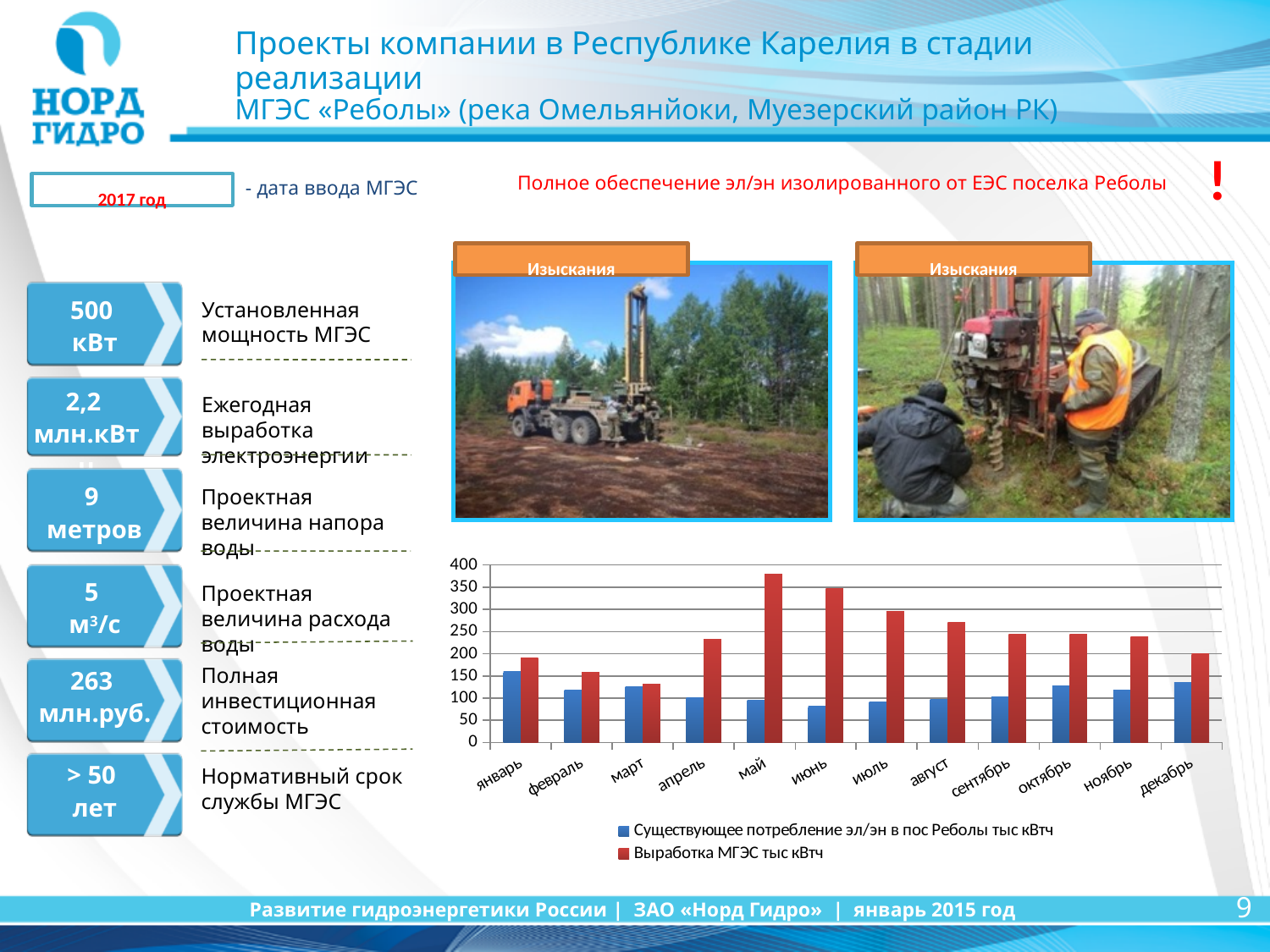
How many series does the chart legend list? 2 In which month is the value for 'Выработка МГЭС тыс кВтч' the highest? май How many months are shown along the x axis of the chart? 12 In which month is the value for 'Существующее потребление эл/эн в пос Реболы тыс кВтч' the highest? январь Is the value for 'Выработка МГЭС тыс кВтч' in май greater or less than 350? greater In which month is the value for 'Существующее потребление эл/эн в пос Реболы тыс кВтч' the lowest? июнь In which month is the value for 'Выработка МГЭС тыс кВтч' the lowest? март Which is larger in июнь: 'Выработка МГЭС тыс кВтч' or 'Существующее потребление эл/эн в пос Реболы тыс кВтч'? Выработка МГЭС тыс кВтч Is the value for 'Выработка МГЭС тыс кВтч' in март greater or less than 150? less What kind of chart is shown on the slide? bar chart Which colour represents 'Выработка МГЭС тыс кВтч' in the chart? red